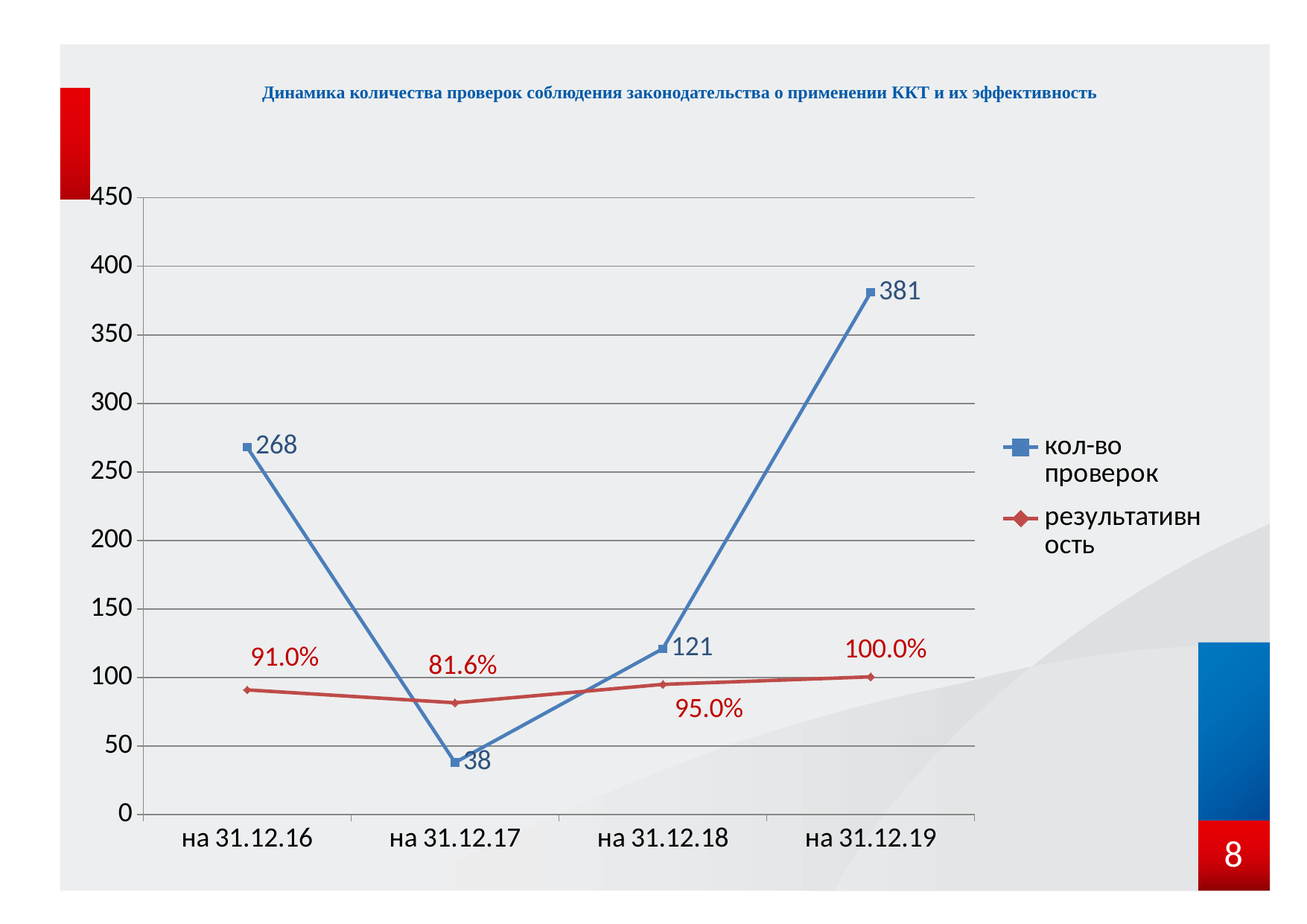
What is the value of "кол-во проверок" at "на 31.12.17"? 38 How many series does the legend list? 2 What is the value of "результативность" at "на 31.12.17"? 81.6% What kind of chart is shown on the slide? line chart What colour is the line for "кол-во проверок"? blue At which date is "кол-во проверок" highest? на 31.12.19 How many dates are shown on the x axis? 4 What is the difference between "кол-во проверок" at "на 31.12.19" and at "на 31.12.16"? 113 Which is larger: "кол-во проверок" at "на 31.12.16" or at "на 31.12.18"? на 31.12.16 What is the value of "кол-во проверок" at "на 31.12.19"? 381 Does "результативность" rise or fall from "на 31.12.17" to "на 31.12.19"? rise At which date is "результативность" lowest? на 31.12.17